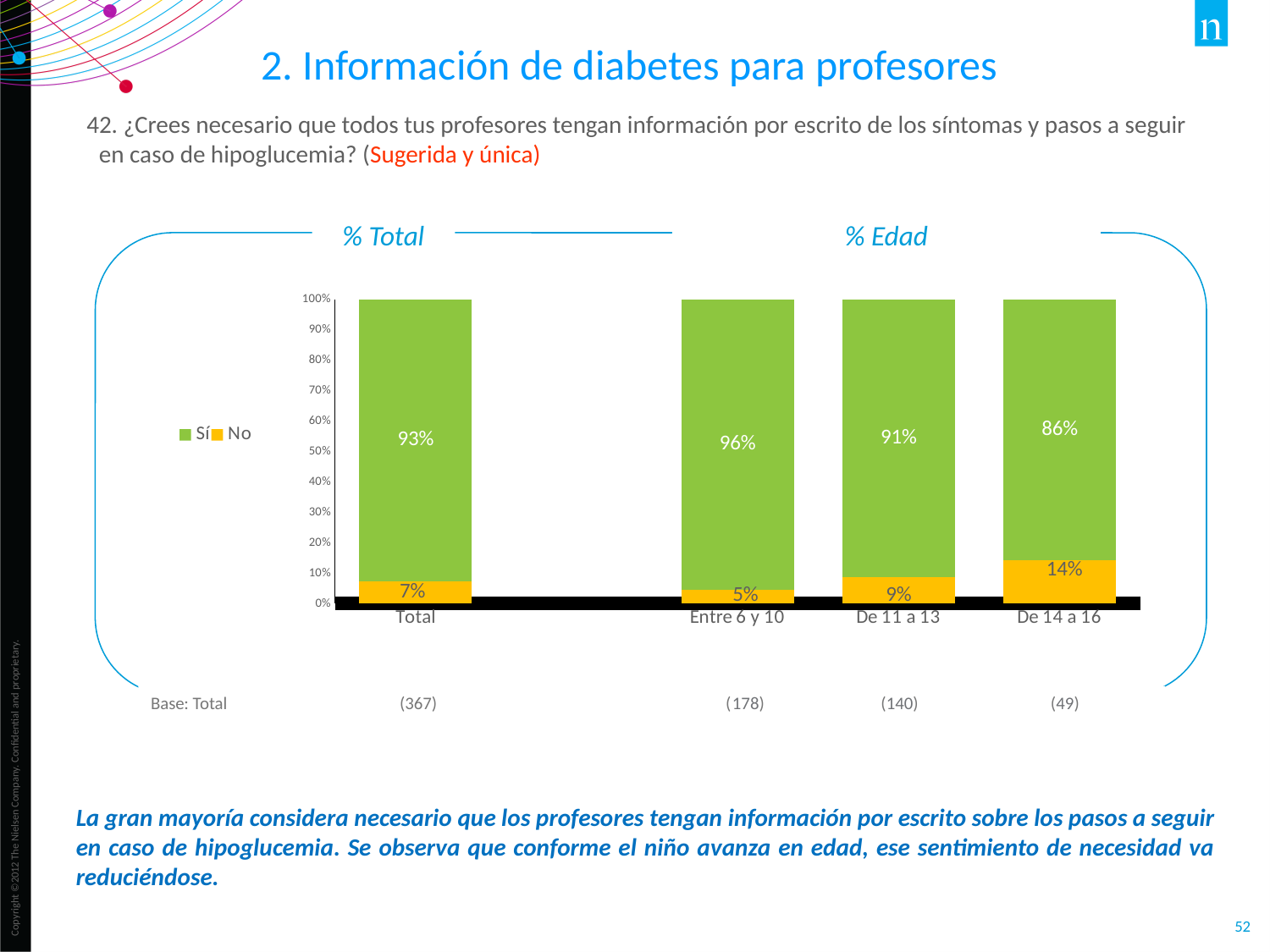
Which category has the lowest 'No' percentage? Entre 6 y 10 Which category has the highest 'Sí' percentage? Entre 6 y 10 What percentage of the 'Entre 6 y 10' group answered 'Sí'? 96% What is the 'Sí' value for the 'Total' category? 93% Which is larger: the 'No' value for 'De 11 a 13' or for 'Total'? De 11 a 13 What is the total of the stacked bar for 'De 11 a 13'? 100% What is the difference between the 'Sí' values for 'Entre 6 y 10' and 'De 14 a 16'? 10% How many categories are shown on the x axis of the chart? 4 Across the age groups from 'Entre 6 y 10' to 'De 14 a 16', does the 'Sí' percentage rise or fall? Fall What kind of chart is shown on the slide? Stacked bar chart How many series does the legend list? 2 What is the 'No' value for the 'De 14 a 16' category? 14%